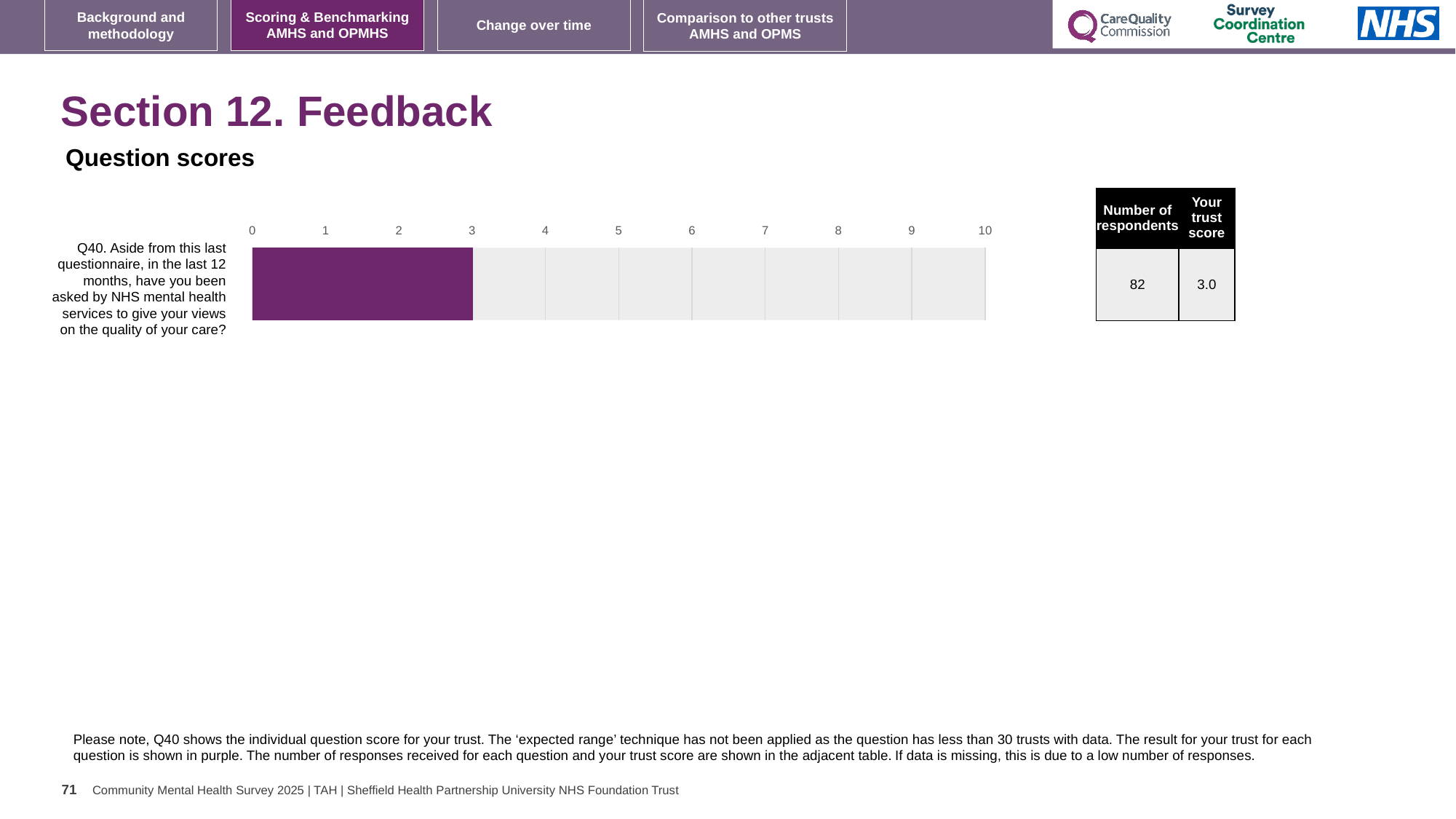
Which axis tick does the bar for Q40 end at? 3 What is the number of respondents for Q40? 82 What colour is the bar for Q40? purple Is the value for Q40 greater or less than 2? greater What is the trust score for Q40 shown in the adjacent table? 3.0 What kind of chart is shown on the slide? bar chart What is the maximum value shown on the chart's axis? 10 Is the value for Q40 greater or less than 5? less How many questions (categories) are plotted in the chart? 1